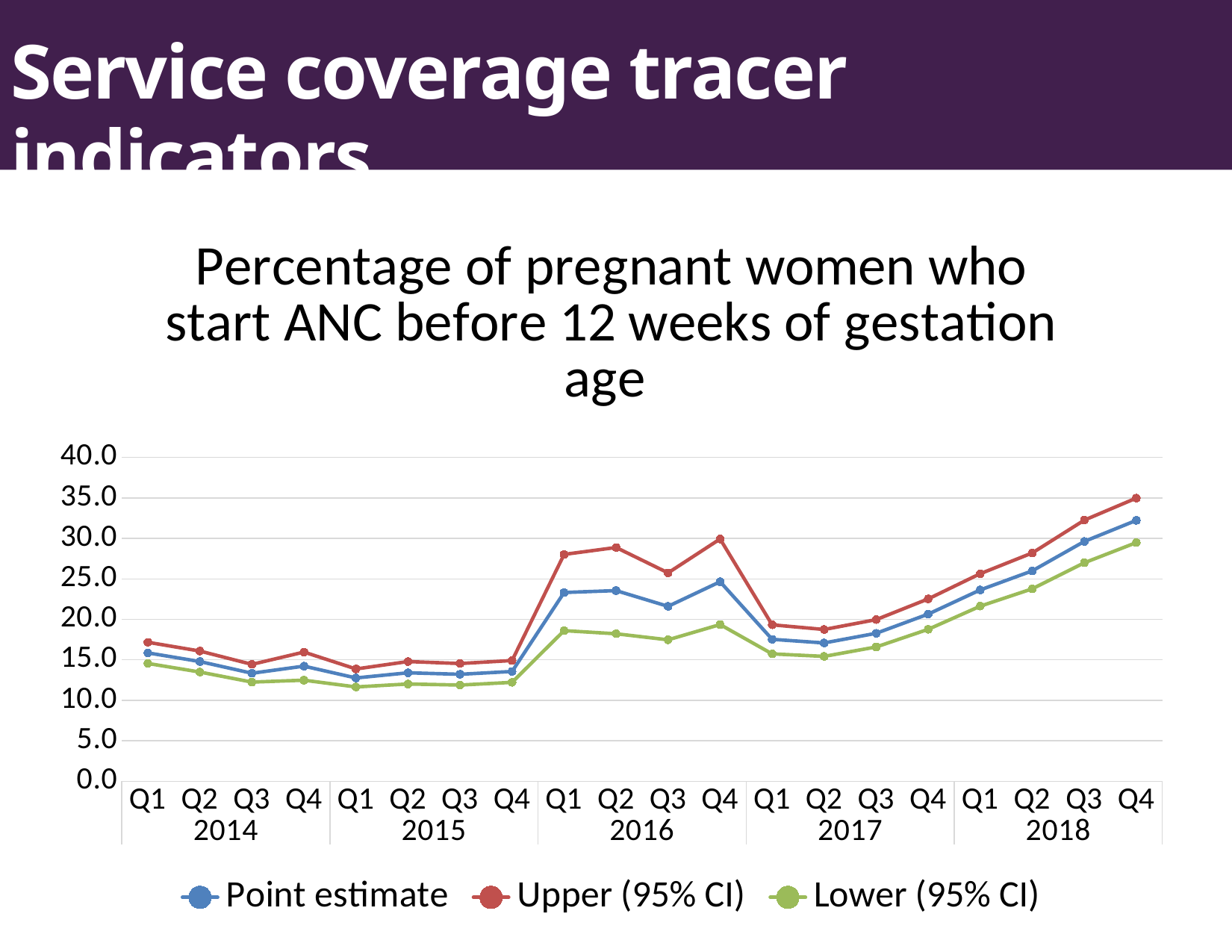
What kind of chart is shown on the slide? line chart In which quarter is the Point estimate highest? Q4 2018 How many series does the legend list? 3 Does the Point estimate rise or fall across the four quarters of 2018? rise In which quarter is the Upper (95% CI) value highest? Q4 2018 How many quarterly data points are plotted along the x axis? 20 Which series is drawn in red? Upper (95% CI) Is the Point estimate for Q4 2018 greater or less than 30? greater Is the Point estimate for Q1 2014 greater or less than 20? less Is the Lower (95% CI) value for Q1 2015 greater or less than 15? less Which is larger, the Point estimate for Q1 2016 or the Point estimate for Q1 2017? Q1 2016